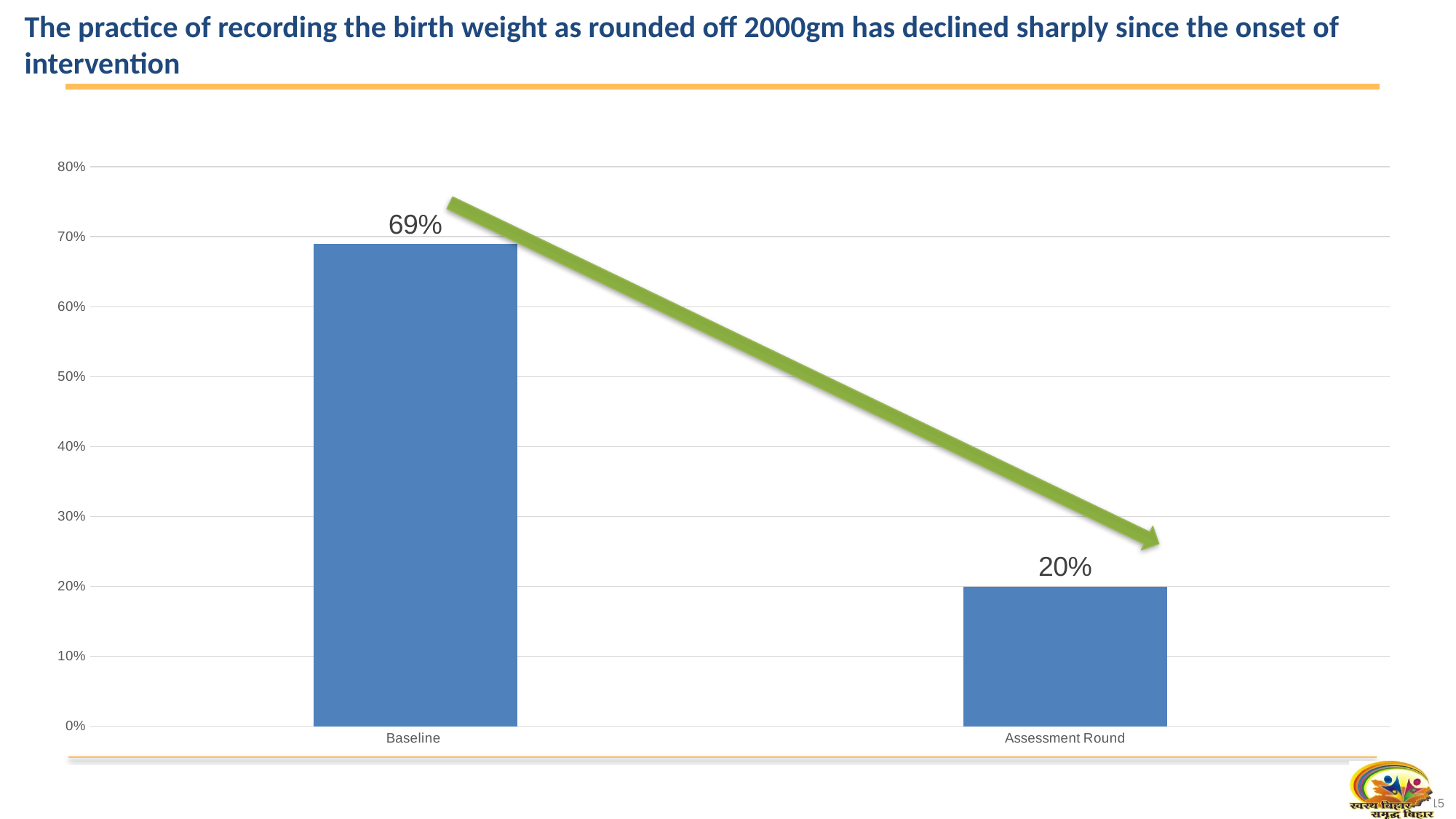
Do the values rise or fall from Baseline to Assessment Round? fall How many categories are shown on the x axis? 2 Is the value for Assessment Round greater or less than 30%? less Which category has the highest value? Baseline Which category has the lowest value? Assessment Round Is the value for Baseline greater or less than 60%? greater What is the difference between the Baseline and Assessment Round values? 49% What is the value for Assessment Round? 20% Which is larger, the value for Baseline or the value for Assessment Round? Baseline What is the value for Baseline? 69% What is the highest value shown on the y axis? 80% What kind of chart is shown on the slide? bar chart